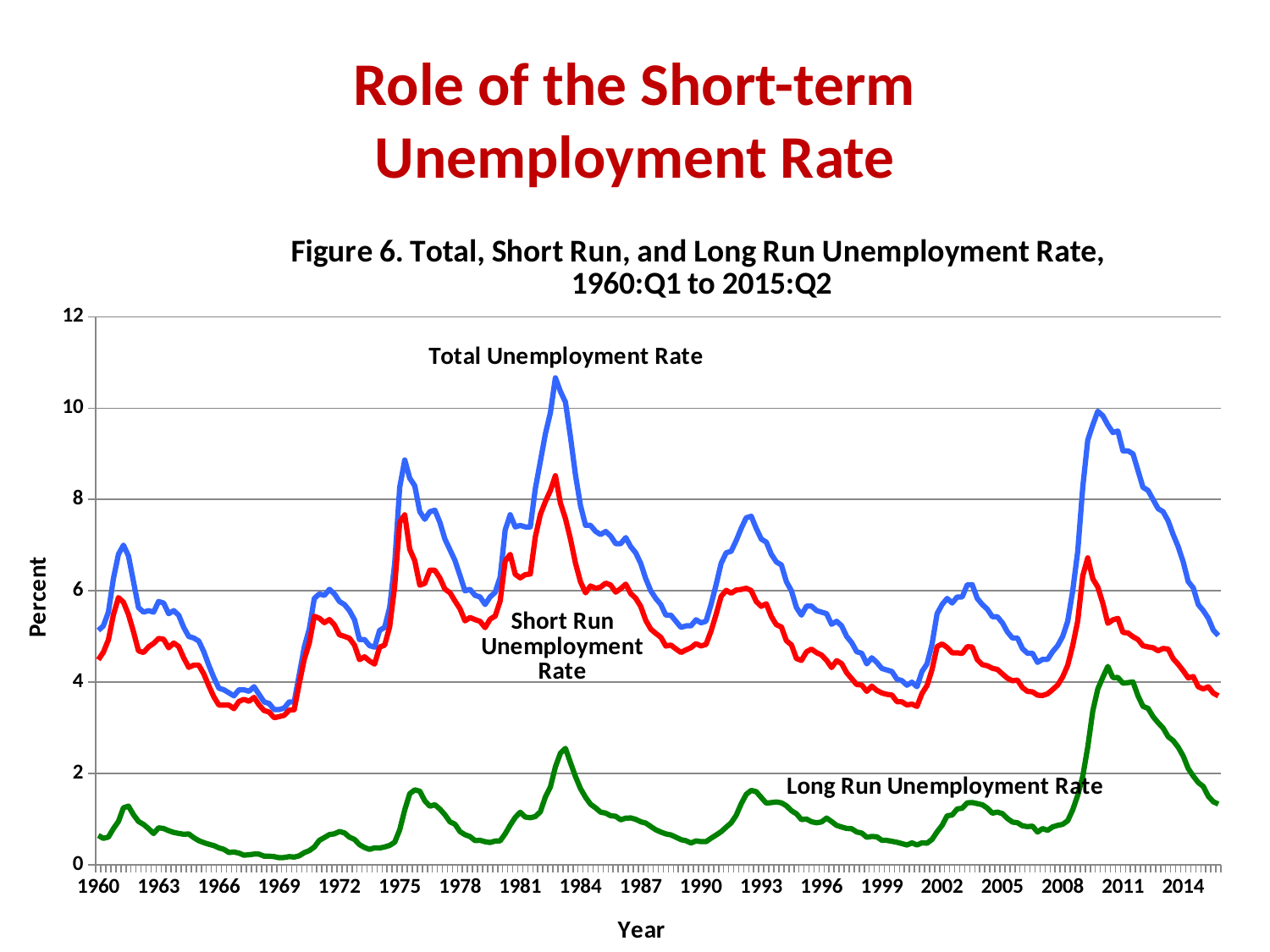
Does the Total Unemployment Rate rise or fall from 2011 to 2014? fall Is the Long Run Unemployment Rate in 1969 greater or less than 2? less Which series has the highest values throughout the chart? Total Unemployment Rate What period does Figure 6 cover according to its title? 1960:Q1 to 2015:Q2 Is the Long Run Unemployment Rate at its peak around 2010 greater or less than 2? greater Around 2010, which is larger: the Short Run Unemployment Rate or the Long Run Unemployment Rate? Short Run Unemployment Rate Which series has the lowest values throughout the chart? Long Run Unemployment Rate Is the peak of the Total Unemployment Rate around 1983 greater or less than 10? greater What kind of chart is shown on the slide? line chart How many series are plotted in Figure 6? 3 What is the label of the vertical axis? Percent